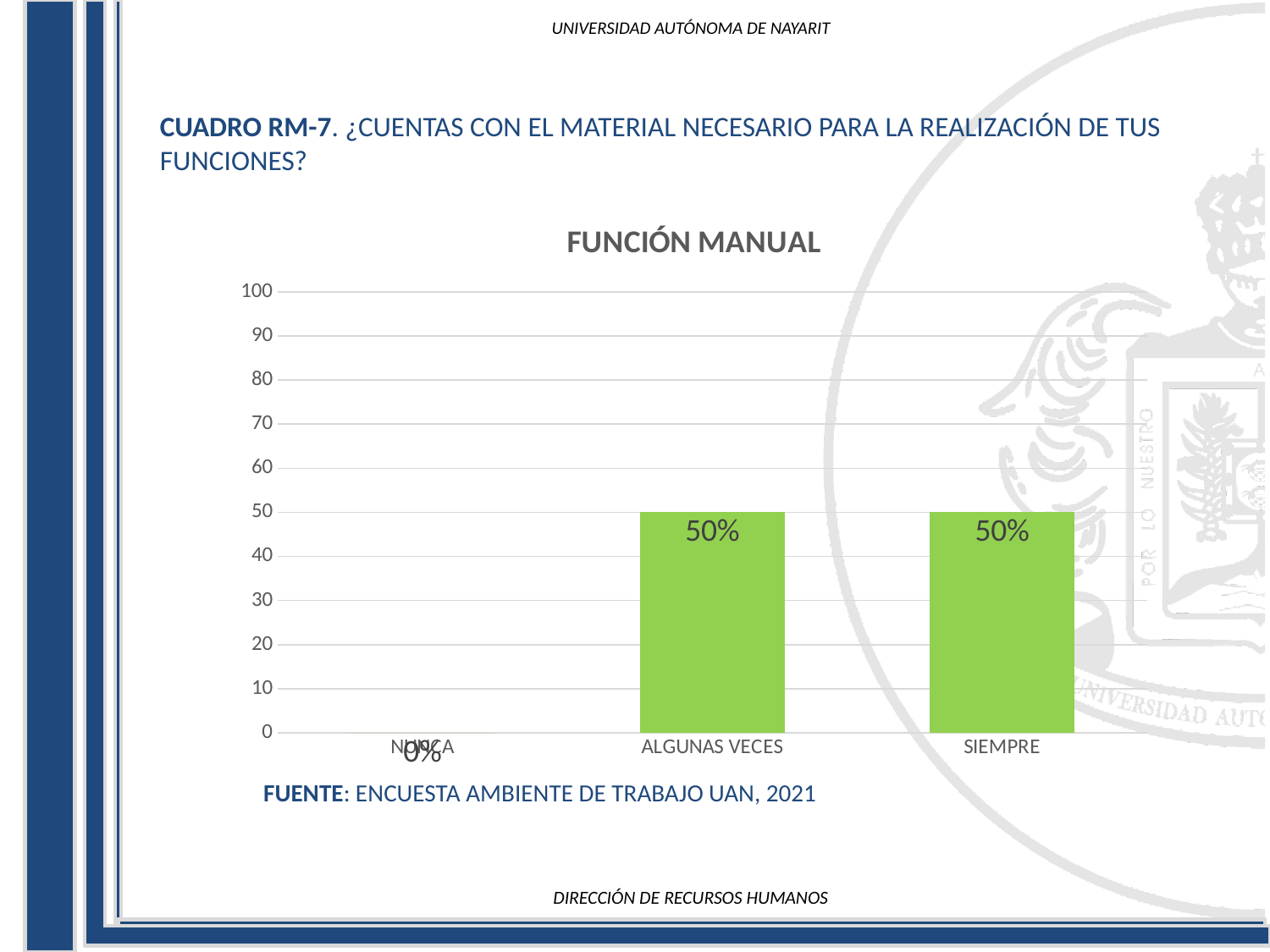
What is the difference between the value for ALGUNAS VECES and the value for NUNCA? 50% Which category has the lowest value? NUNCA What is the title of the chart? FUNCIÓN MANUAL What is the value for NUNCA? 0% What type of chart is shown on the slide? bar chart Is the value for ALGUNAS VECES greater or less than 60? less What is the value for ALGUNAS VECES? 50% How many categories are shown on the x axis? 3 Which is larger, the value for NUNCA or the value for SIEMPRE? SIEMPRE Is the value for SIEMPRE greater or less than 40? greater What is the highest value shown on the y axis? 100 What is the value for SIEMPRE? 50%